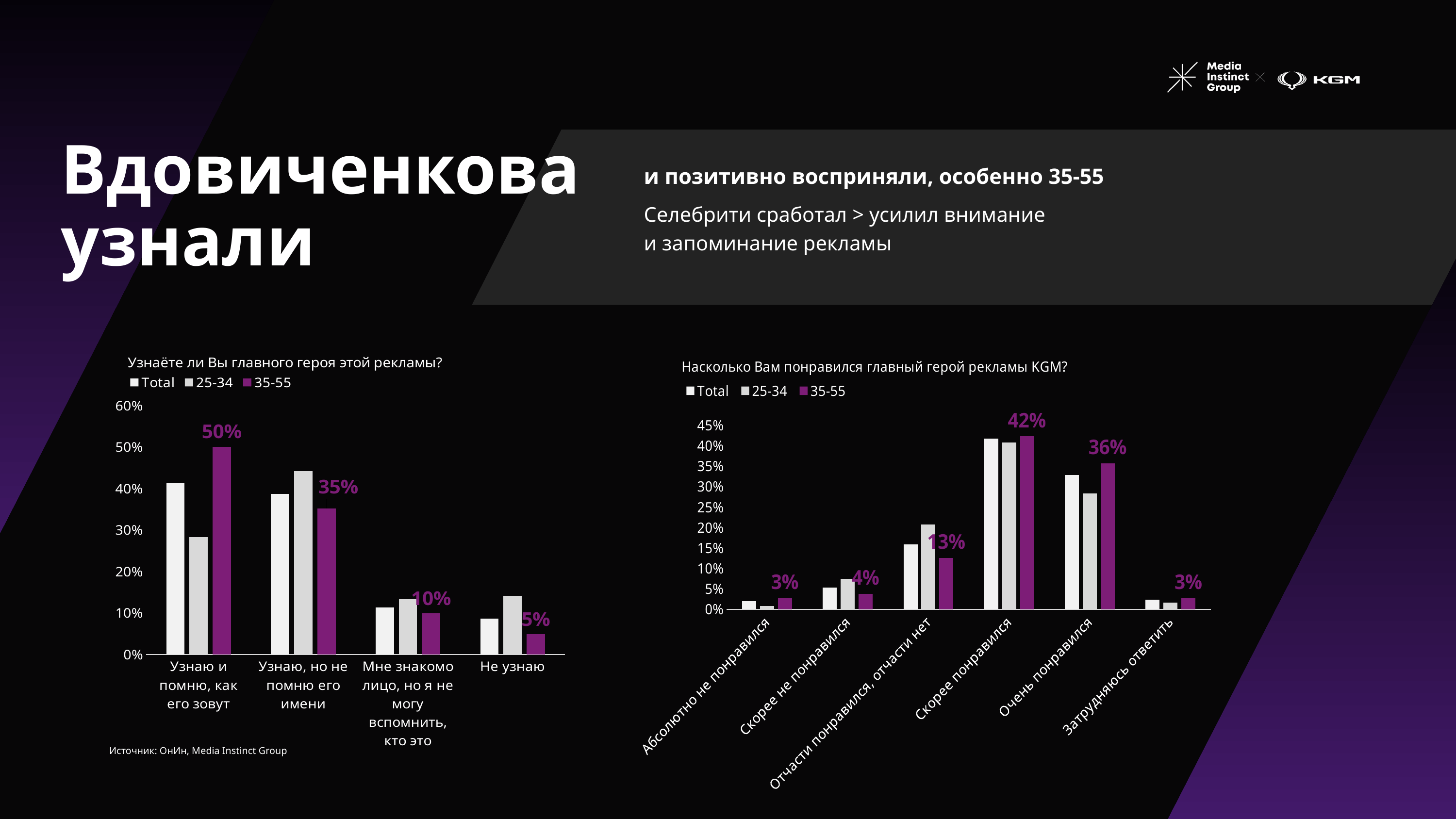
In the chart titled "Узнаёте ли Вы главного героя этой рекламы?", what is the value for the 35-55 series in the category "Узнаю и помню, как его зовут"? 50% In the chart titled "Узнаёте ли Вы главного героя этой рекламы?", what is the difference between the 35-55 values for "Узнаю и помню, как его зовут" and "Узнаю, но не помню его имени"? 15% In the chart titled "Насколько Вам понравился главный герой рекламы KGM?", is the 25-34 value for "Отчасти понравился, отчасти нет" greater or less than 15%? greater In the chart titled "Узнаёте ли Вы главного героя этой рекламы?", is the Total value for "Узнаю и помню, как его зовут" greater or less than 40%? greater In the chart titled "Насколько Вам понравился главный герой рекламы KGM?", how many categories are shown on the x axis? 6 What type of chart is the chart titled "Насколько Вам понравился главный герой рекламы KGM?"? Bar chart In the chart titled "Узнаёте ли Вы главного героя этой рекламы?", how many series does the legend list? 3 In the chart titled "Насколько Вам понравился главный герой рекламы KGM?", what is the value for the 35-55 series in the category "Очень понравился"? 36% In the chart titled "Насколько Вам понравился главный герой рекламы KGM?", which is larger for the 35-55 series: "Скорее понравился" or "Очень понравился"? Скорее понравился In the chart titled "Насколько Вам понравился главный герой рекламы KGM?", what is the value for the 35-55 series in the category "Скорее понравился"? 42% In the chart titled "Узнаёте ли Вы главного героя этой рекламы?", what is the value for the 35-55 series in the category "Не узнаю"? 5% In the chart titled "Узнаёте ли Вы главного героя этой рекламы?", which category has the highest value for the 35-55 series? Узнаю и помню, как его зовут